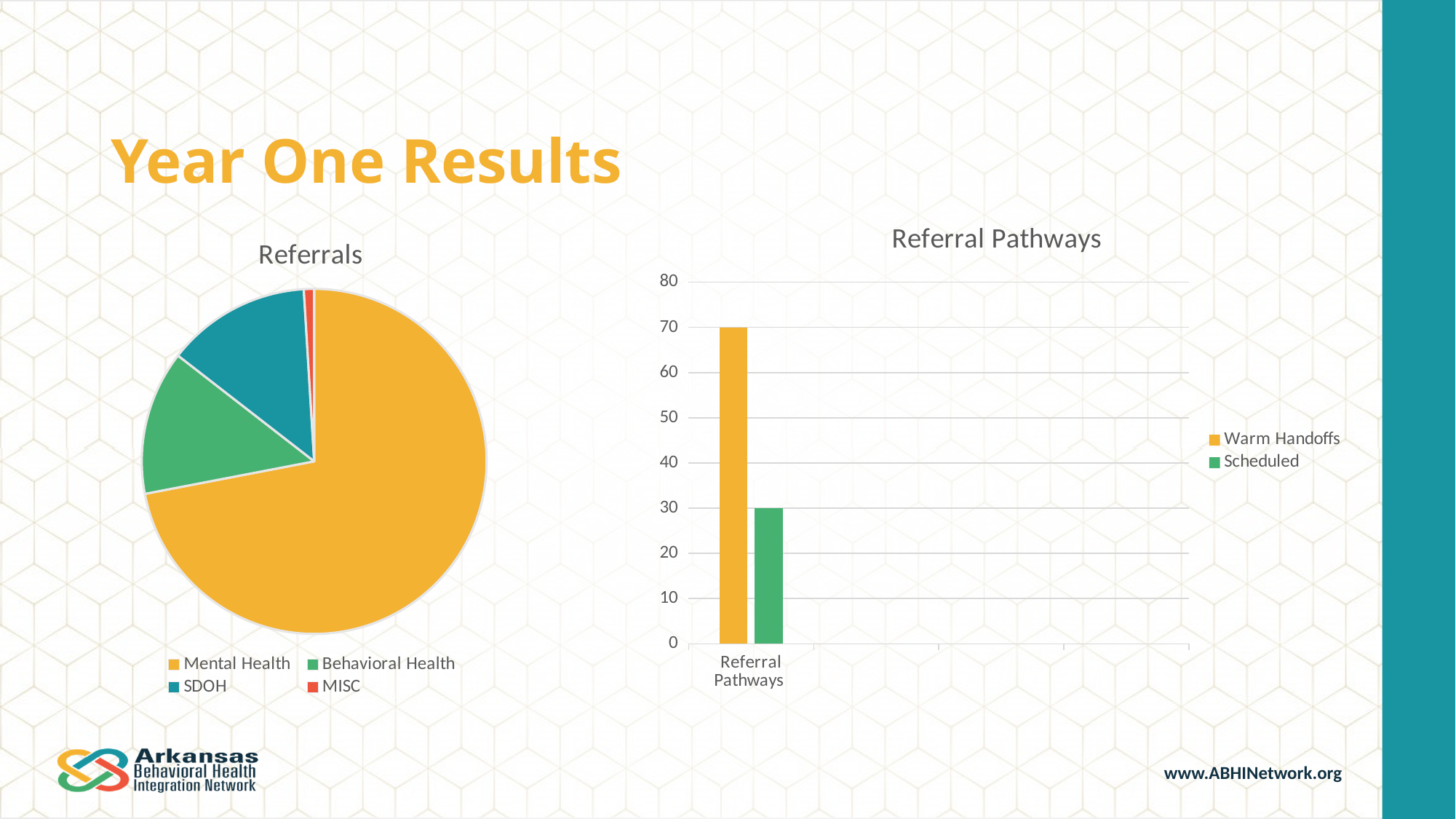
In the Referral Pathways chart, what is the value for Scheduled? 30 In the Referrals chart, which category has the smallest slice? MISC In the Referrals chart, which slice is larger: SDOH or MISC? SDOH In the Referral Pathways chart, what is the value for Warm Handoffs? 70 How many categories does the Referrals pie chart show? 4 In the Referral Pathways chart, what is the difference between Warm Handoffs and Scheduled? 40 What kind of chart is the Referrals chart? Pie chart In the Referrals chart, what colour is the Behavioral Health slice? Green In the Referral Pathways chart, which series is higher: Warm Handoffs or Scheduled? Warm Handoffs What kind of chart is the Referral Pathways chart? Bar chart In the Referrals chart, which category has the largest slice? Mental Health How many series does the legend of the Referral Pathways chart list? 2